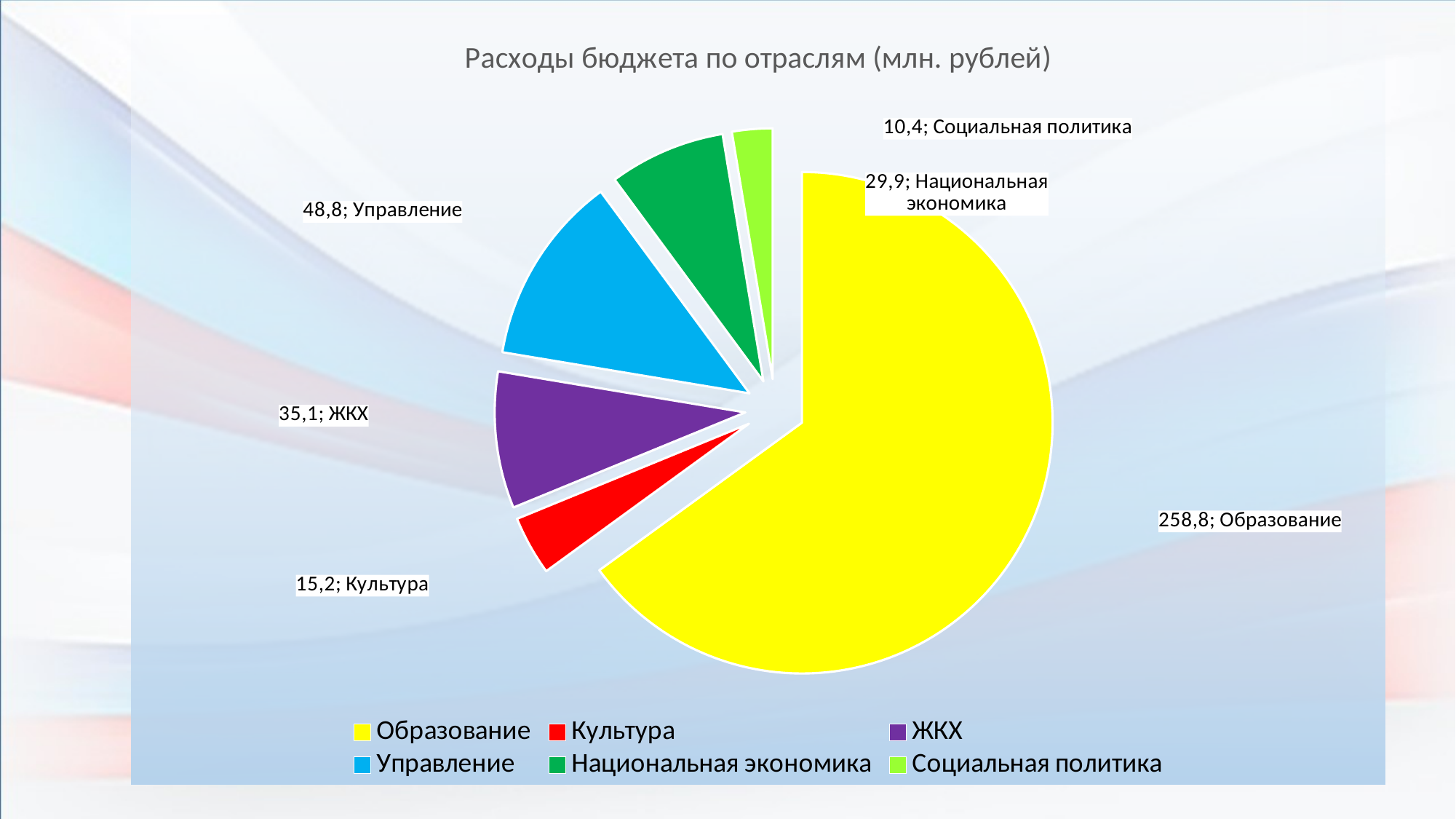
How many categories does the pie chart have? 6 Which category has the largest value? Образование What is the difference between the values for Национальная экономика and Социальная политика? 19,5 Which is larger, the value for Культура or the value for ЖКХ? ЖКХ What colour is the slice for Культура? red What is the difference between the values for Управление and ЖКХ? 13,7 What is the value for Управление? 48,8 What is the title of the chart? Расходы бюджета по отраслям (млн. рублей) What is the value for Образование? 258,8 What kind of chart is shown on the slide? pie chart What is the value for Социальная политика? 10,4 Which category has the smallest value? Социальная политика